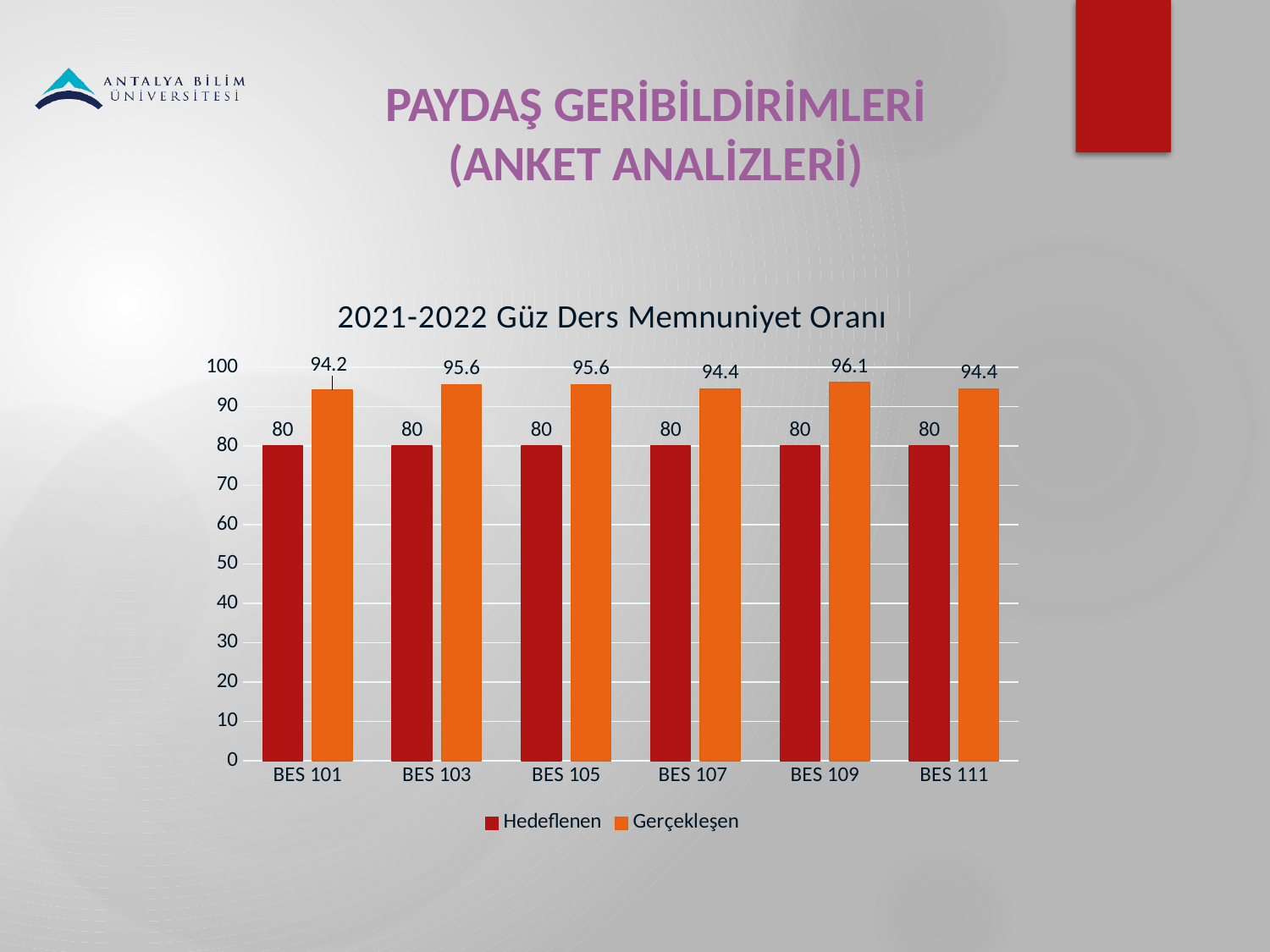
What is the Gerçekleşen value for BES 109? 96.1 How many series does the legend list? 2 Which is larger for BES 105: the Hedeflenen value or the Gerçekleşen value? Gerçekleşen What is the Gerçekleşen value for BES 101? 94.2 What kind of chart is shown on the slide? Bar chart Which category has the lowest Gerçekleşen value? BES 101 What is the difference between the Gerçekleşen and Hedeflenen values for BES 103? 15.6 What is the difference between the Gerçekleşen values for BES 109 and BES 111? 1.7 What is the Hedeflenen value for BES 107? 80 What is the title of the chart? 2021-2022 Güz Ders Memnuniyet Oranı Which category has the highest Gerçekleşen value? BES 109 How many categories are shown on the x axis? 6